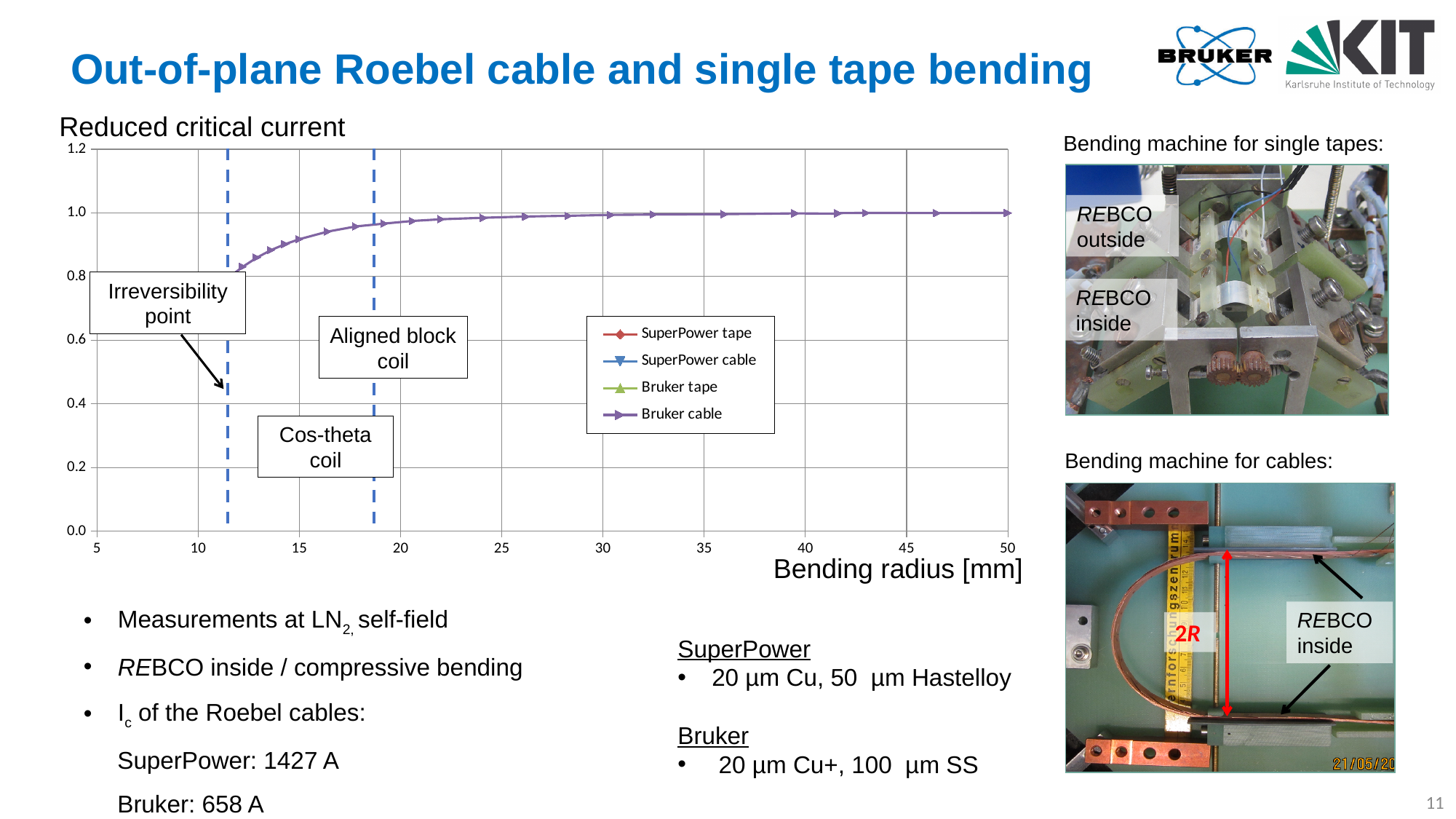
Does the plotted Bruker cable curve rise or fall as the bending radius increases? rise How many series does the chart's legend list? 4 What is the label of the x axis of the chart? Bending radius [mm] Is the Bruker cable value at a bending radius of 50 mm greater or less than 0.8? greater What is the maximum value shown on the y axis of the chart? 1.2 What is the title of the chart? Reduced critical current Is the Bruker cable value at its smallest plotted bending radius (about 12 mm) greater or less than 1.0? less What kind of chart is shown on the slide? line chart Is the Bruker cable value at a bending radius of 30 mm greater or less than 0.8? greater Which is larger for the Bruker cable: the value at a bending radius of 12 mm or at 40 mm? 40 mm